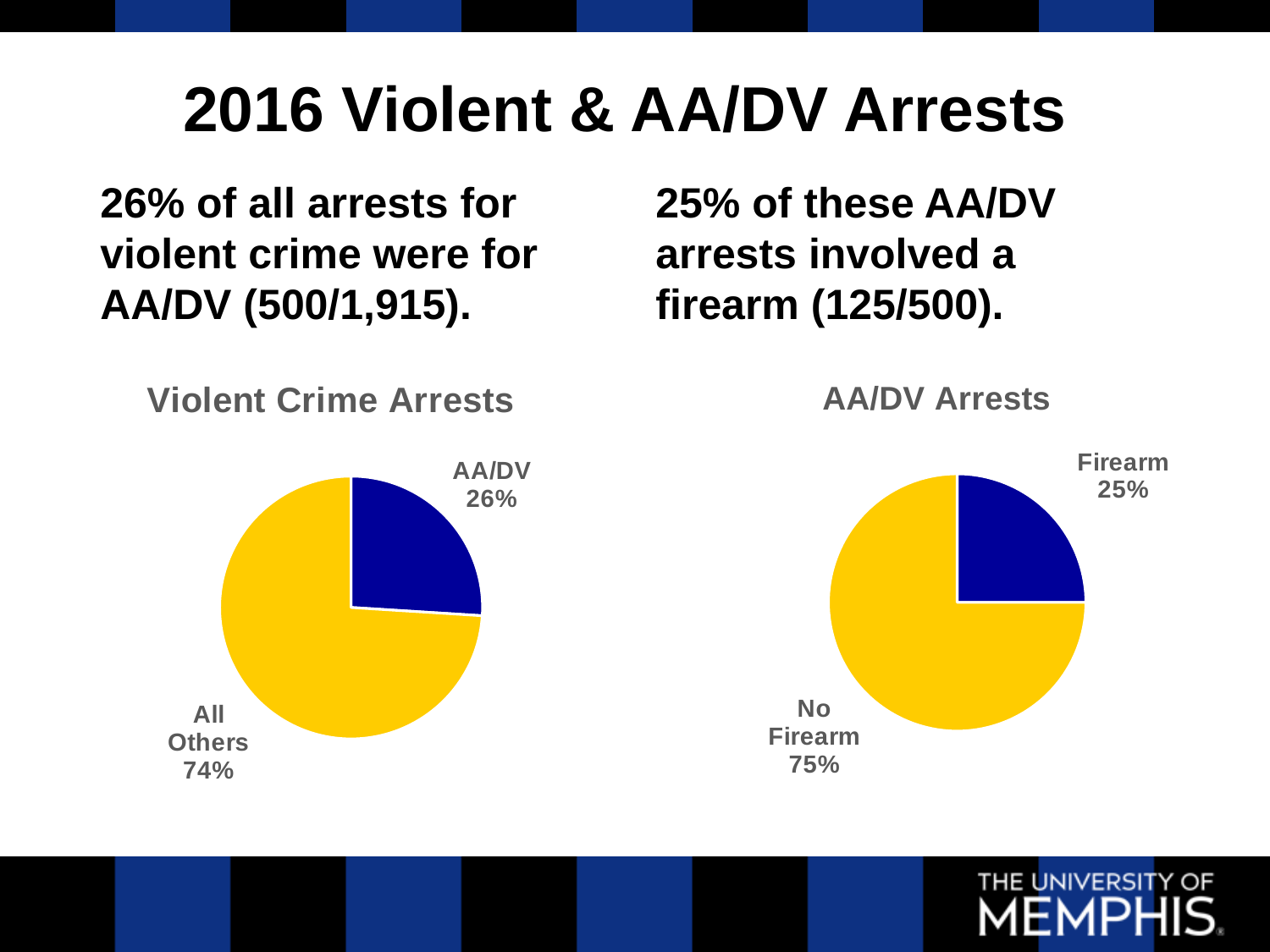
In the AA/DV Arrests chart, which slice is the smallest? Firearm In the Violent Crime Arrests chart, which slice is the largest? All Others In the AA/DV Arrests chart, which is larger, Firearm or No Firearm? No Firearm In the Violent Crime Arrests chart, what is the difference in percentage points between All Others and AA/DV? 48 How many slices does the AA/DV Arrests pie chart have? 2 In the AA/DV Arrests chart, what is the difference in percentage points between No Firearm and Firearm? 50 In the AA/DV Arrests chart, what share of arrests is labelled No Firearm? 75% In the Violent Crime Arrests chart, what share of arrests is labelled All Others? 74% In the Violent Crime Arrests chart, what share of arrests were for AA/DV? 26% In the Violent Crime Arrests chart, what colour is the AA/DV slice? Blue In the AA/DV Arrests chart, what share of arrests involved a firearm? 25% What kind of chart is the Violent Crime Arrests chart? Pie chart